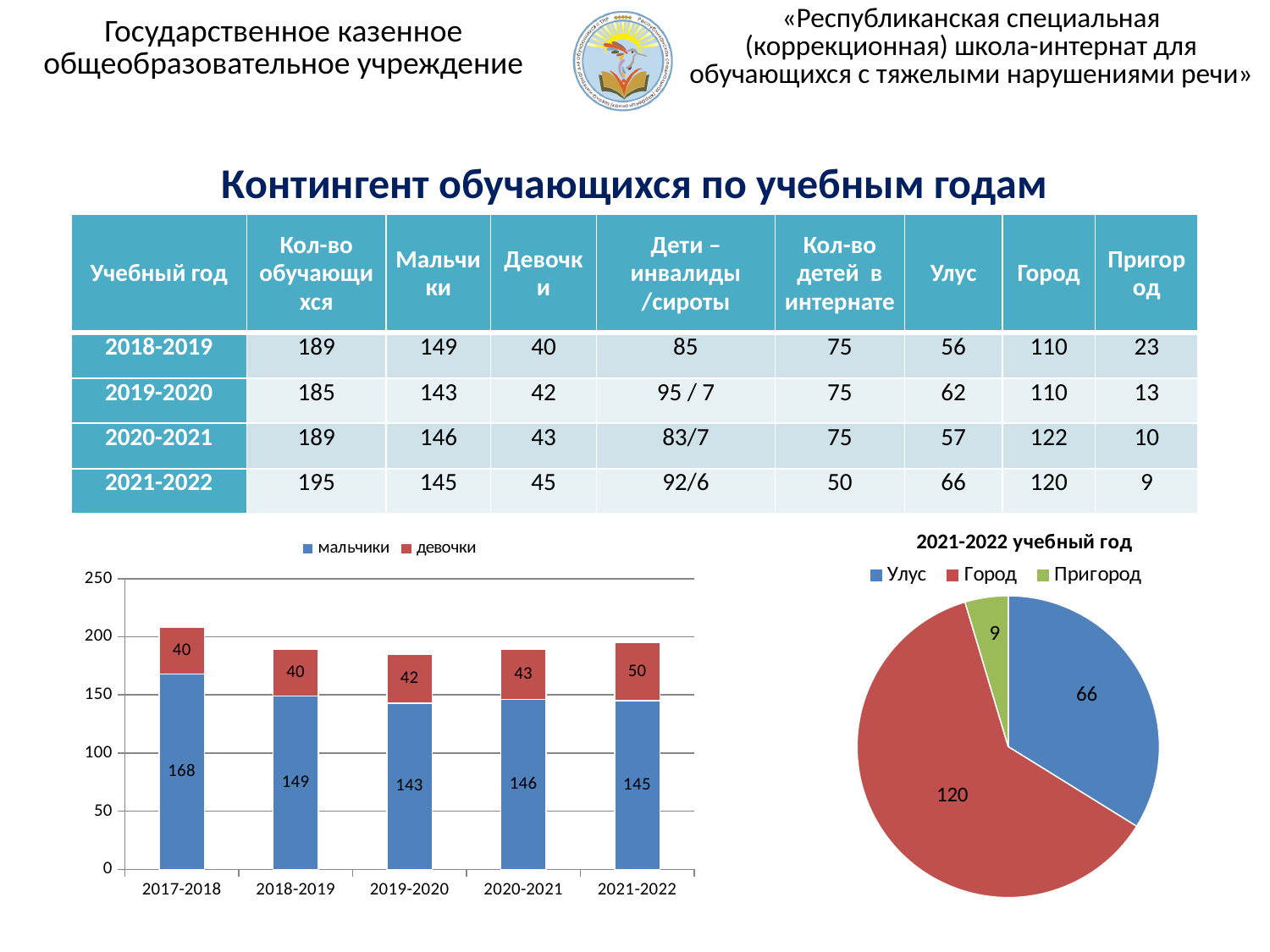
In the pie chart titled '2021-2022 учебный год', which is larger, Улус or Город? Город In the bar chart on the left, what is the difference between the мальчики values for 2017-2018 and 2018-2019? 19 What kind of chart is the chart on the left? Stacked bar chart In the bar chart on the left, how many series does the legend list? 2 In the bar chart on the left, what is the value for мальчики in 2017-2018? 168 In the pie chart titled '2021-2022 учебный год', which category has the smallest slice? Пригород In the bar chart on the left, how many years are shown on the x axis? 5 In the pie chart titled '2021-2022 учебный год', what is the value for Город? 120 In the bar chart on the left, what is the total of the stacked bar for 2020-2021? 189 In the bar chart on the left, which year has the lowest value for мальчики? 2019-2020 In the bar chart on the left, what is the value for девочки in 2021-2022? 50 In the bar chart on the left, which year has the highest value for мальчики? 2017-2018